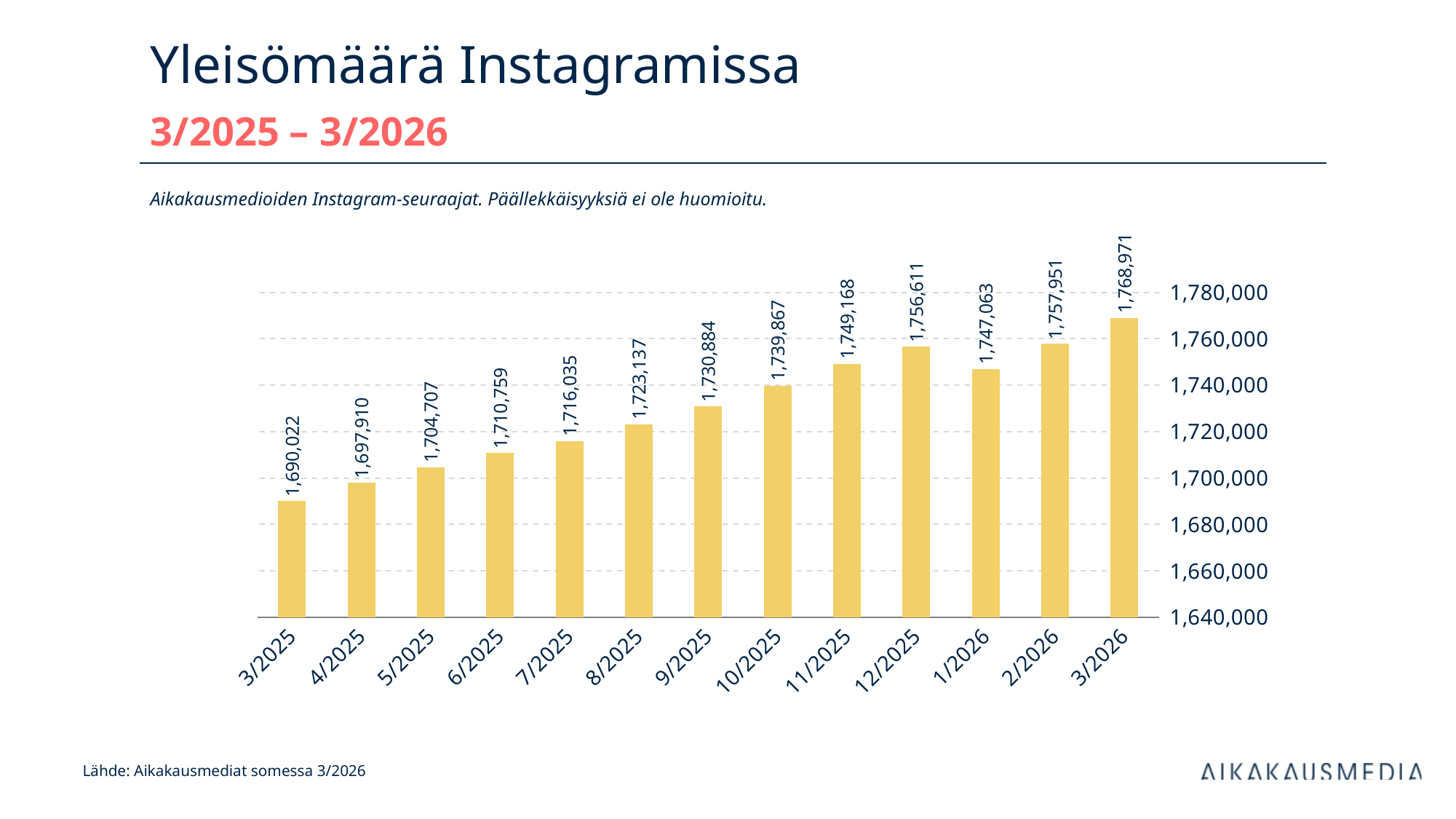
What is the value for 1/2026? 1,747,063 What is the difference between the values for 3/2026 and 3/2025? 78,949 What is the value for 10/2025? 1,739,867 Do the values generally rise or fall from 3/2025 to 3/2026? Rise What kind of chart is shown on the slide? Bar chart What is the difference between the values for 12/2025 and 1/2026? 9,548 Which is larger, the value for 12/2025 or the value for 1/2026? 12/2025 How many months are shown on the x axis? 13 What is the value for 3/2025? 1,690,022 Is the value for 8/2025 greater or less than 1,720,000? greater Which month has the lowest value? 3/2025 Which month has the highest value? 3/2026